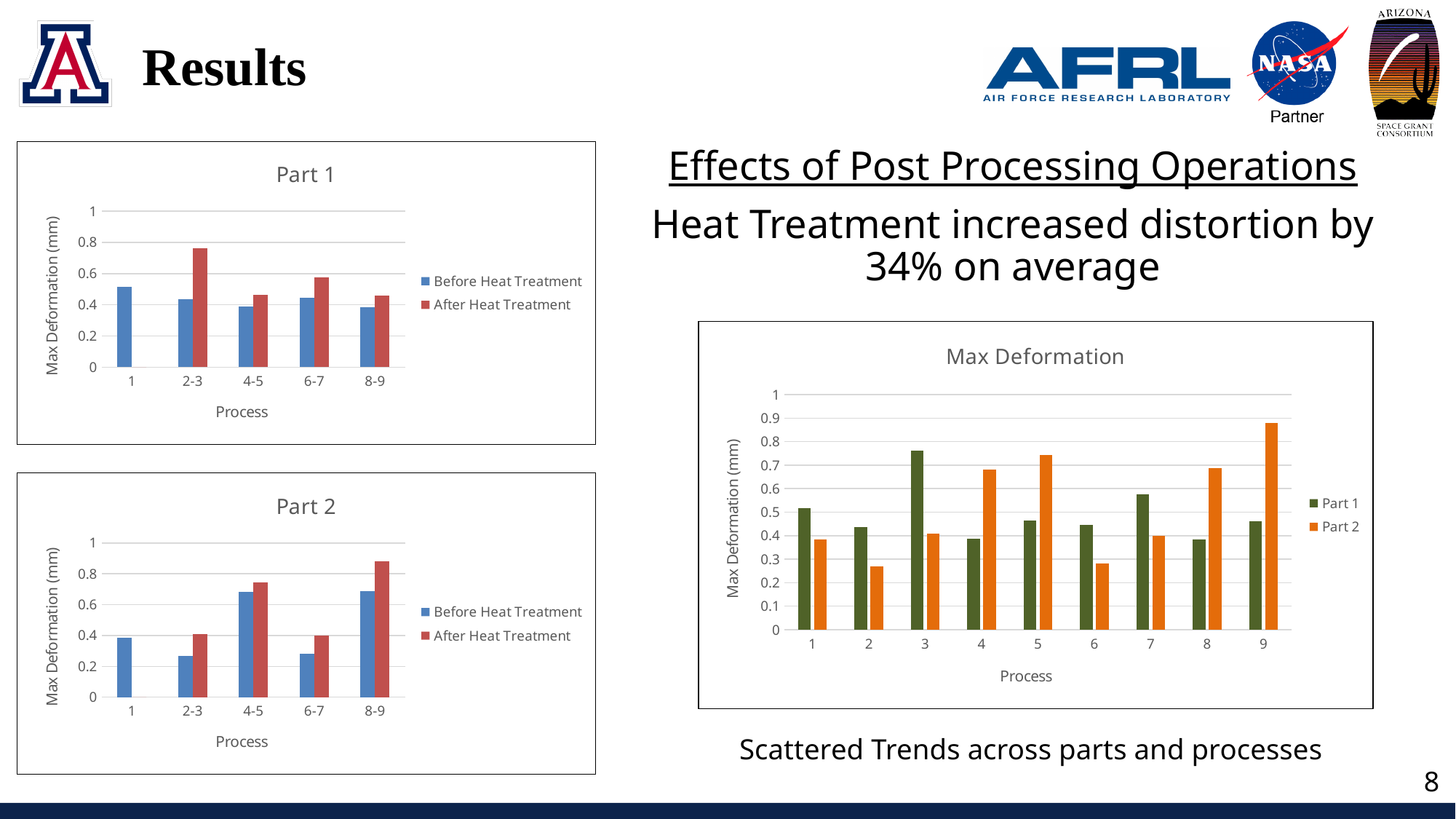
On the Part 1 chart, which process has the highest After Heat Treatment value? 2-3 On the Part 1 chart, is the Before Heat Treatment value for process 1 greater or less than 0.4? greater On the Max Deformation chart, which process has the highest Part 1 value? 3 On the Part 2 chart, which process has the highest After Heat Treatment value? 8-9 On the Max Deformation chart, which series has the larger value at process 4, Part 1 or Part 2? Part 2 On the Part 2 chart, which is larger: the After Heat Treatment value for process 4-5 or for process 8-9? 8-9 On the Max Deformation chart, how many processes are shown on the x axis? 9 On the Part 1 chart, what kind of chart is shown? bar chart On the Part 1 chart, how many series does the legend list? 2 On the Max Deformation chart, is the Part 2 value for process 2 greater or less than 0.3? less On the Part 2 chart, is the Before Heat Treatment value for process 2-3 greater or less than 0.4? less